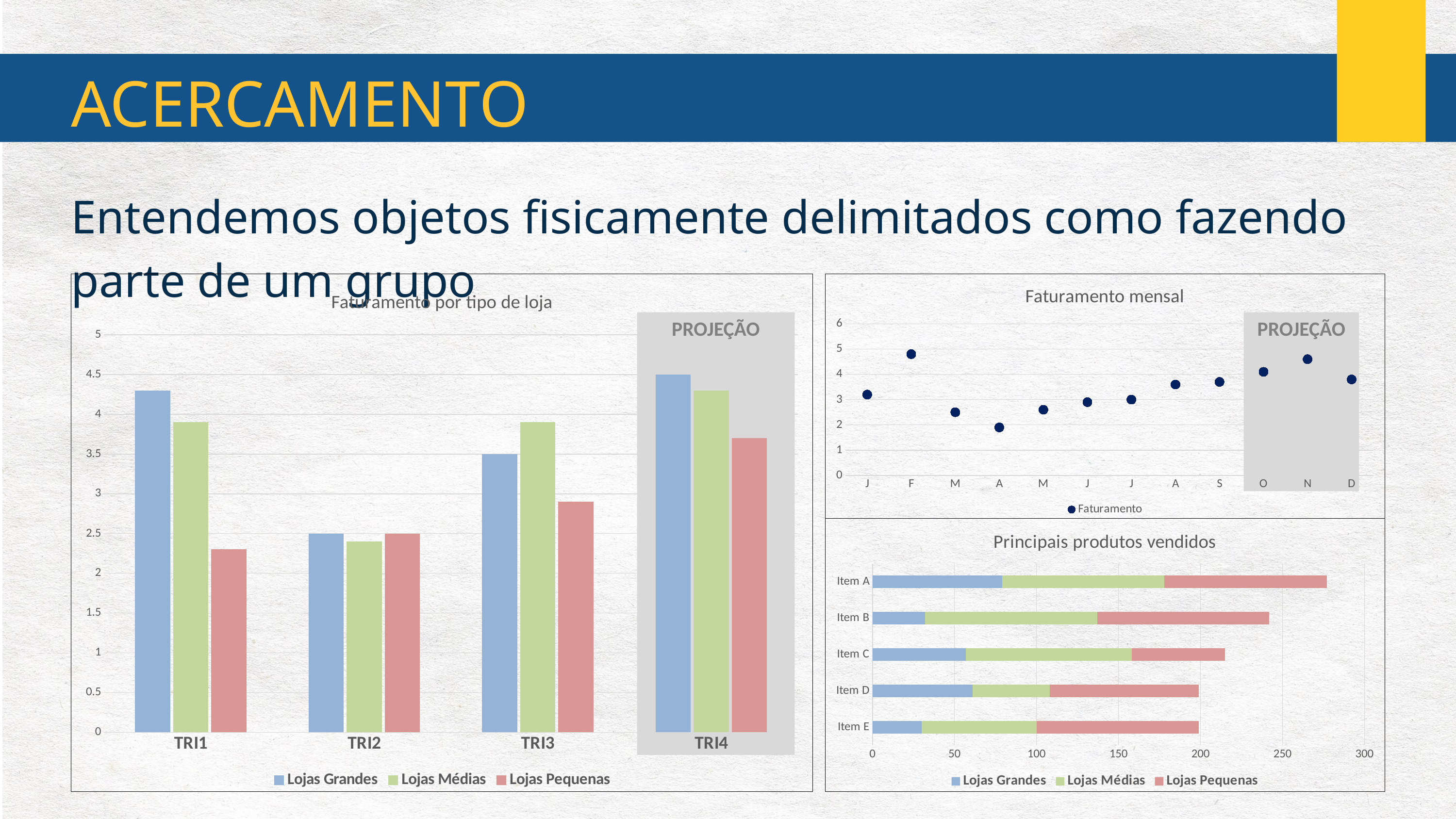
What kind of chart is "Faturamento por tipo de loja"? bar chart In "Faturamento por tipo de loja", which category is marked as PROJEÇÃO? TRI4 In "Faturamento por tipo de loja", which category has the highest Lojas Grandes value? TRI4 In "Faturamento por tipo de loja", is the Lojas Grandes value for TRI1 greater or less than 4? greater In "Faturamento mensal", which month has the lowest value? A How many categories are shown on the x axis of "Faturamento por tipo de loja"? 4 In "Faturamento mensal", is the value for F greater or less than 4? greater In "Faturamento por tipo de loja", which is larger for TRI3: Lojas Grandes or Lojas Médias? Lojas Médias How many series does the legend of "Faturamento por tipo de loja" list? 3 How many data points are plotted in "Faturamento mensal"? 12 In "Faturamento por tipo de loja", which category has the lowest Lojas Pequenas value? TRI1 In "Principais produtos vendidos", which item has the longest total bar? Item A